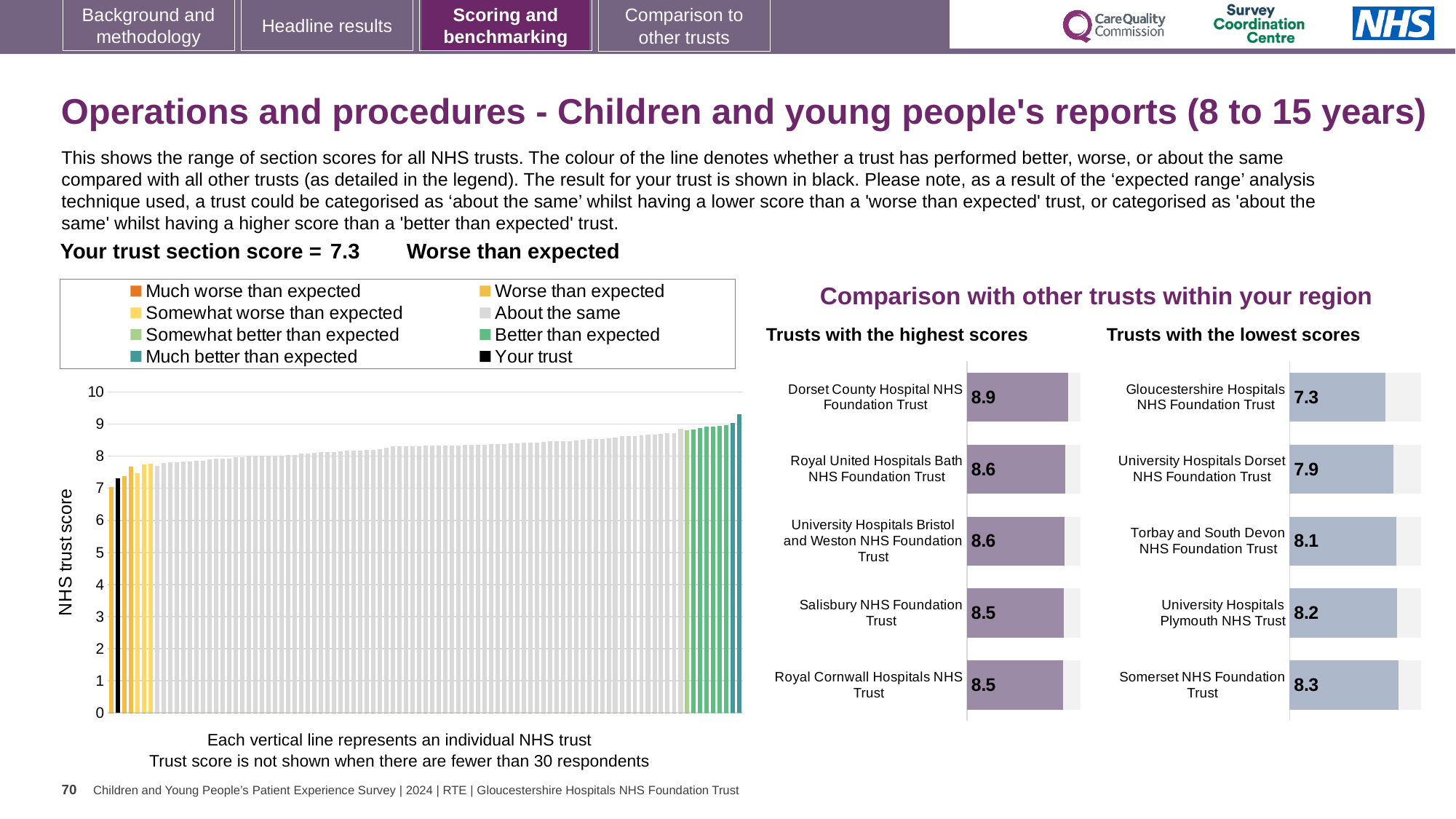
How many trusts are shown in the 'Trusts with the highest scores' chart? 5 In the 'Trusts with the lowest scores' chart, what is the score for Somerset NHS Foundation Trust? 8.3 In the left-hand NHS trust score chart, do the bar values rise or fall from left to right? Rise In the 'Trusts with the lowest scores' chart, which trust has the lowest score? Gloucestershire Hospitals NHS Foundation Trust In the 'Trusts with the highest scores' chart, what is the score for Dorset County Hospital NHS Foundation Trust? 8.9 In the 'Trusts with the lowest scores' chart, what is the difference between the scores of Somerset NHS Foundation Trust and Gloucestershire Hospitals NHS Foundation Trust? 1.0 What kind of chart is the 'Trusts with the lowest scores' chart? Bar chart What is the y-axis title of the left-hand chart showing all NHS trusts? NHS trust score In the 'Trusts with the highest scores' chart, which trust has the highest score? Dorset County Hospital NHS Foundation Trust In the 'Trusts with the lowest scores' chart, which has the higher score: Torbay and South Devon NHS Foundation Trust or University Hospitals Plymouth NHS Trust? University Hospitals Plymouth NHS Trust How many entries does the legend of the left-hand NHS trust score chart list? 8 In the 'Trusts with the highest scores' chart, what is the difference between the scores of Dorset County Hospital NHS Foundation Trust and Royal Cornwall Hospitals NHS Trust? 0.4